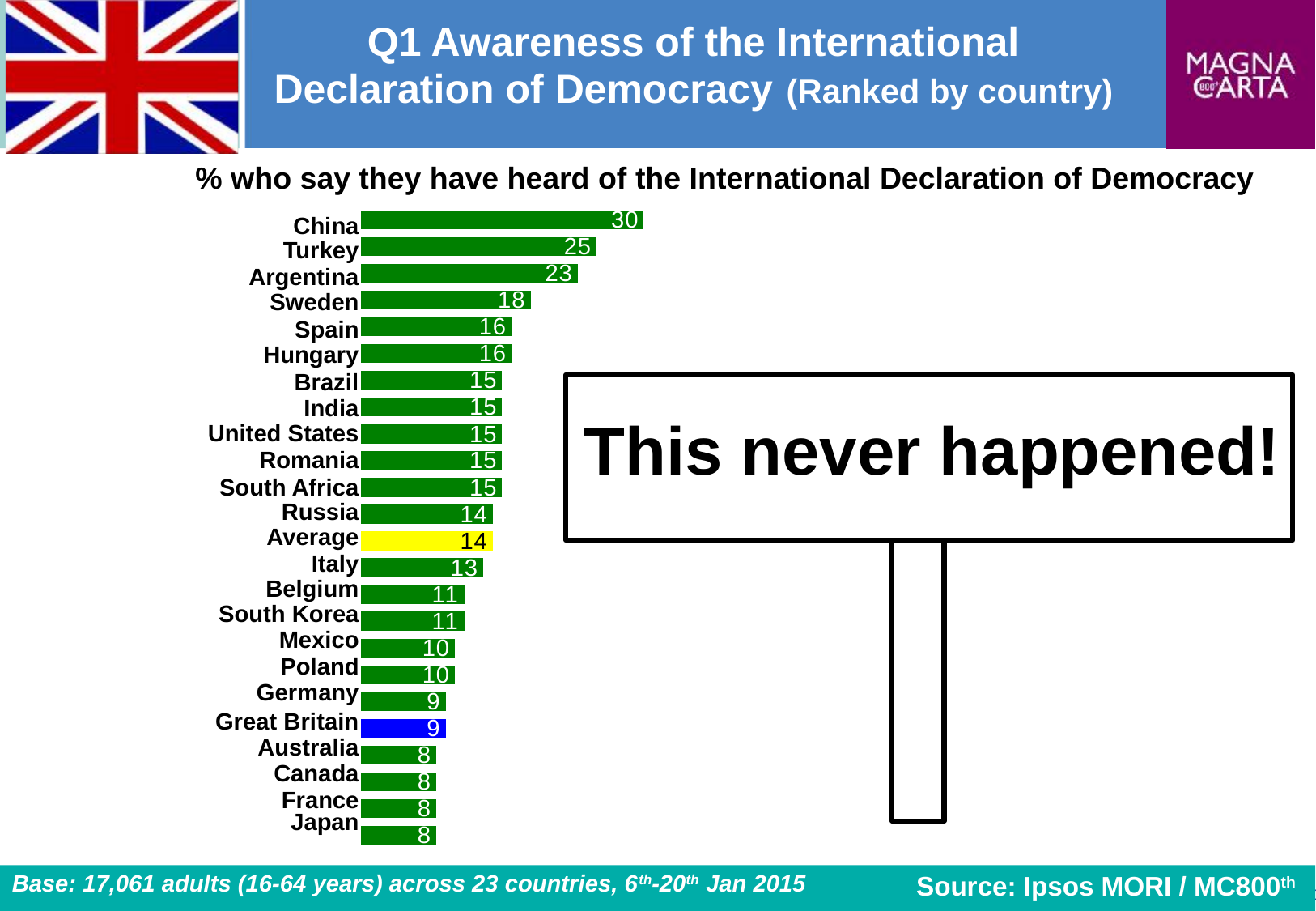
What is the value shown for the Average bar? 14 What type of chart is shown on the slide? Bar chart Which has a higher value, Italy or Belgium? Italy Which country has the highest percentage who say they have heard of the International Declaration of Democracy? China What is the difference between the values for China and Turkey? 5 Which has a higher value, Argentina or Sweden? Argentina What is the value shown for Japan? 8 What is the value shown for Great Britain? 9 What is the difference between the values for Sweden and Great Britain? 9 Which bar in the chart is coloured yellow? Average How many bars are plotted in the chart, including the Average bar? 24 What percentage of respondents in China say they have heard of the International Declaration of Democracy? 30